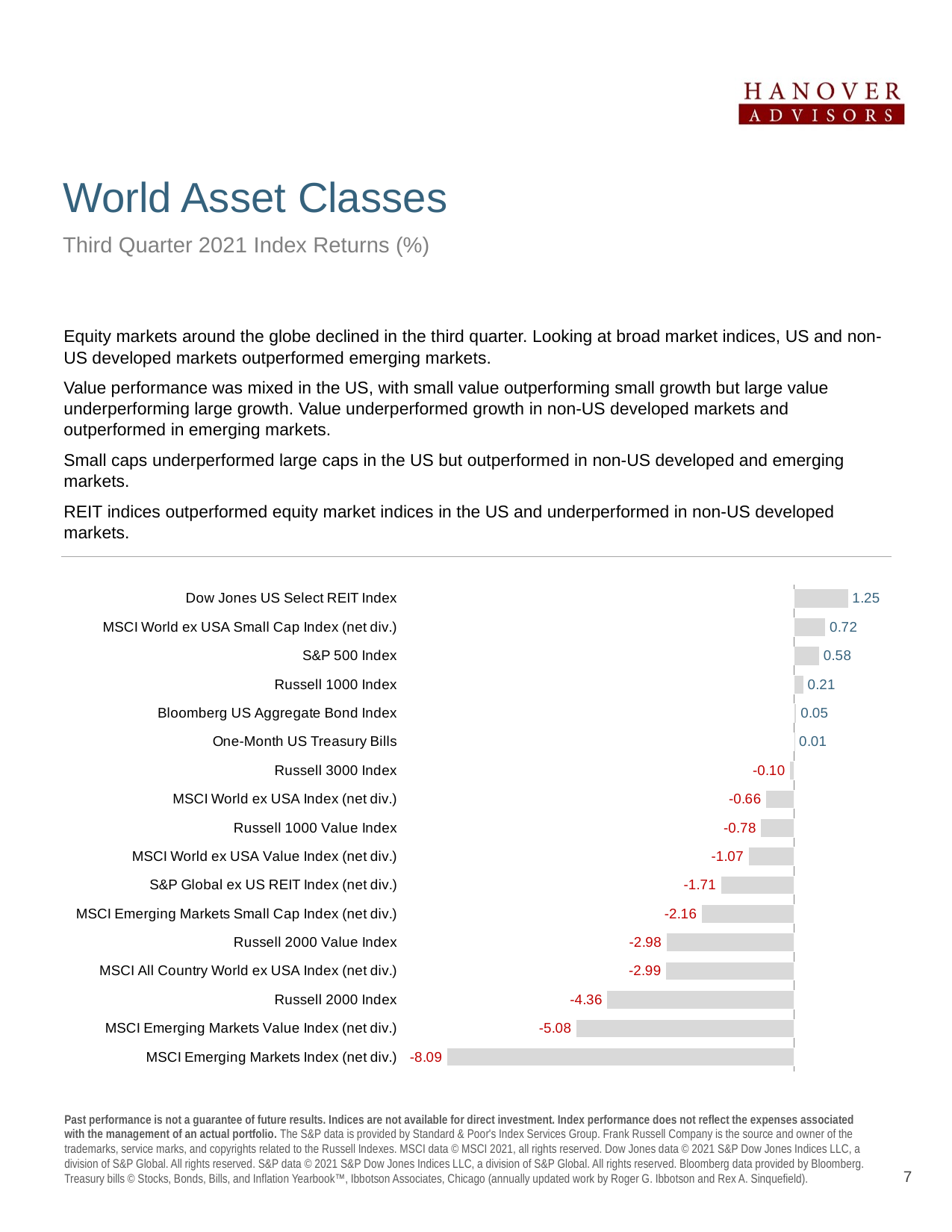
Which index has the lowest return in the chart? MSCI Emerging Markets Index (net div.) What is the value for the Bloomberg US Aggregate Bond Index? 0.05 What is the subtitle of the slide describing the chart's data? Third Quarter 2021 Index Returns (%) What is the third quarter 2021 return for the Dow Jones US Select REIT Index? 1.25 What is the difference between the returns of the Dow Jones US Select REIT Index and the S&P 500 Index? 0.67 Which has the higher return, the S&P 500 Index or the Russell 1000 Index? S&P 500 Index What type of chart is used to show the index returns? Bar chart How many indices are shown in the chart? 17 What return is shown for the Russell 2000 Index? -4.36 What is the difference between the returns of the Russell 2000 Value Index and the Russell 2000 Index? 1.38 What is the value shown for the MSCI Emerging Markets Index (net div.)? -8.09 Which index has the highest return in the chart? Dow Jones US Select REIT Index